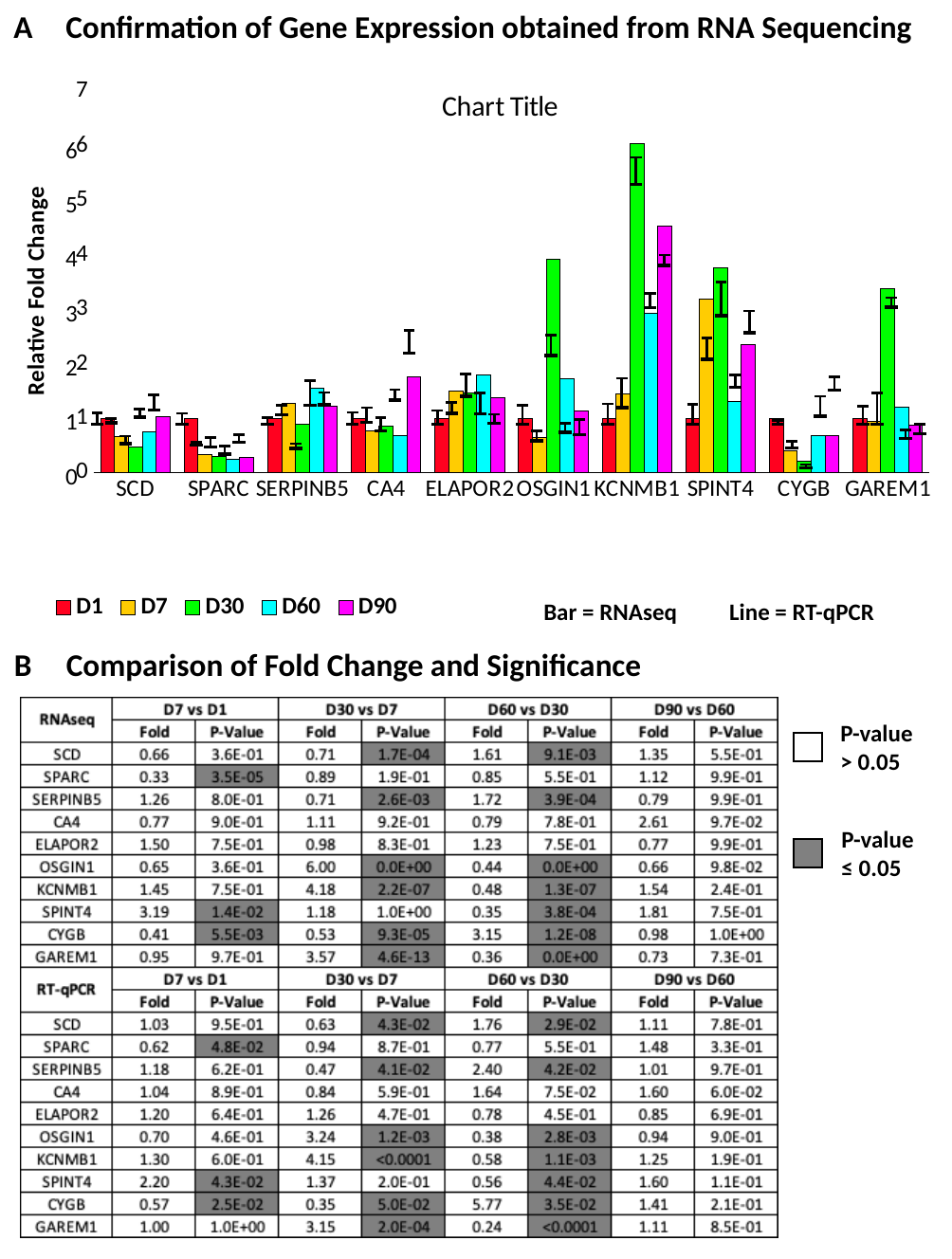
In the chart in panel A, is the D7 bar for SPARC greater or less than 1? less In the chart in panel A, which series has the highest bar for KCNMB1? D30 What is the y-axis label of the chart in panel A? Relative Fold Change In the chart in panel A, is the D30 bar for KCNMB1 greater or less than 5? greater How many series does the legend of the chart in panel A list? 5 In the chart in panel A, which gene has the tallest bar overall? KCNMB1 In the chart in panel A, which is larger for SPINT4, the D7 bar or the D60 bar? D7 What kind of chart is shown in panel A? bar chart In the chart in panel A, is the D30 bar for OSGIN1 greater or less than 3? greater In the chart in panel A, which series has the highest bar for CA4? D90 In the chart in panel A, which is larger for CA4, the D60 bar or the D90 bar? D90 How many genes (categories) are shown on the x axis of the chart in panel A? 10